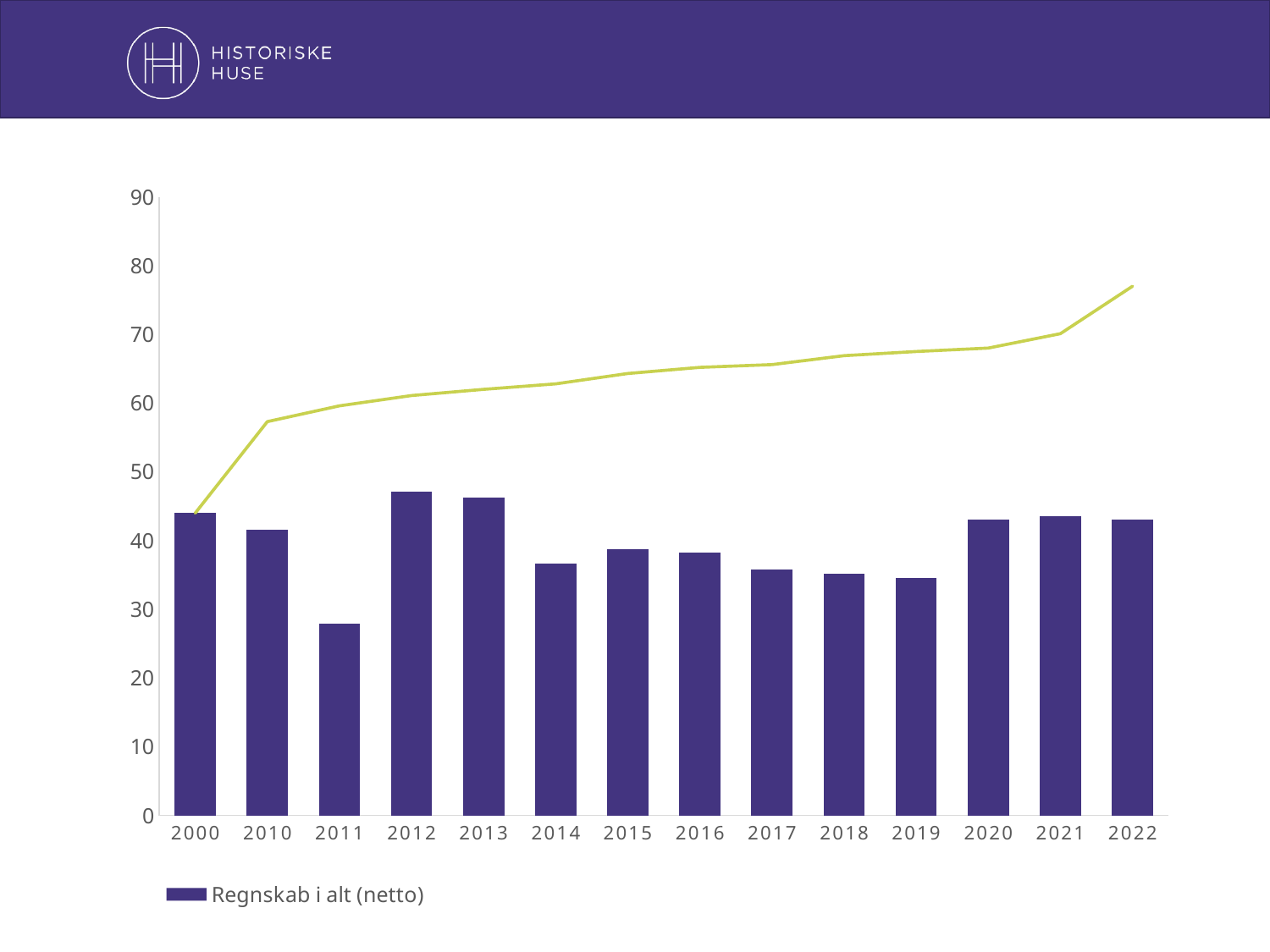
How many series does the legend list? 1 What kind of chart is shown on the slide? A bar chart with a line overlaid Is the value of the line for 2000 greater or less than 50? less Is the bar for 2019 greater or less than 40? less Is the bar for 2011 greater or less than 30? less What is the name of the series shown in the legend? Regnskab i alt (netto) How many years are shown on the x axis of the chart? 14 Does the line rise or fall from 2000 to 2022? rises Which bar is taller, 2000 or 2019? 2000 Which year has the lowest bar for Regnskab i alt (netto)? 2011